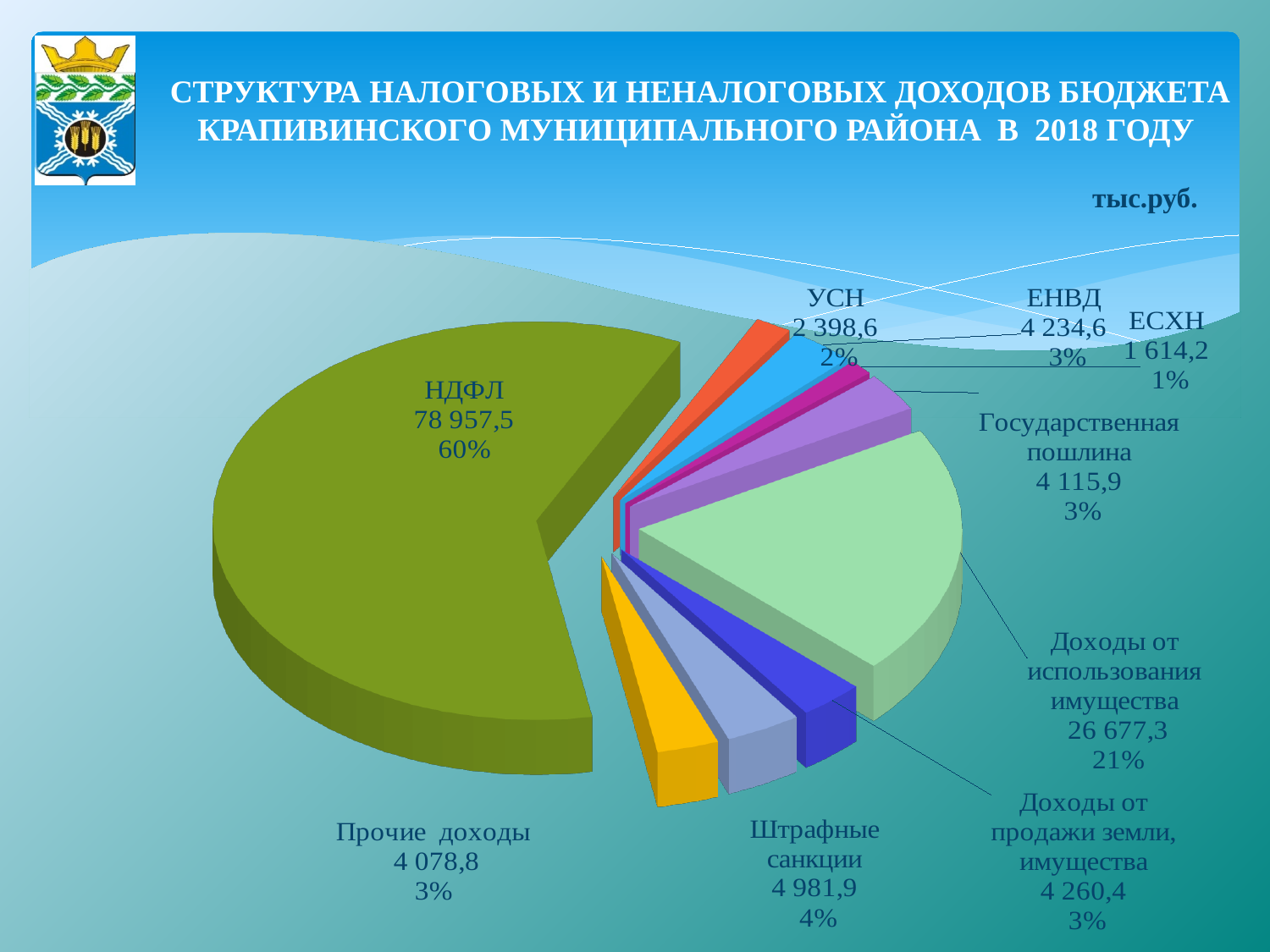
What is the value for Штрафные санкции? 4 981,9 What is the difference between the values for НДФЛ and Доходы от использования имущества? 52 280,2 Which category has the smallest share of the pie? ЕСХН What share of the pie does УСН represent? 2% What kind of chart is shown on the slide? pie chart Which is larger, the value for ЕНВД or the value for Государственная пошлина? ЕНВД What is the value for Доходы от использования имущества? 26 677,3 Which category has the largest share of the pie? НДФЛ In what units are the values on the chart given? тыс.руб. What is the value for НДФЛ? 78 957,5 How many categories (slices) does the pie chart show? 9 What share of the pie does Доходы от использования имущества represent? 21%